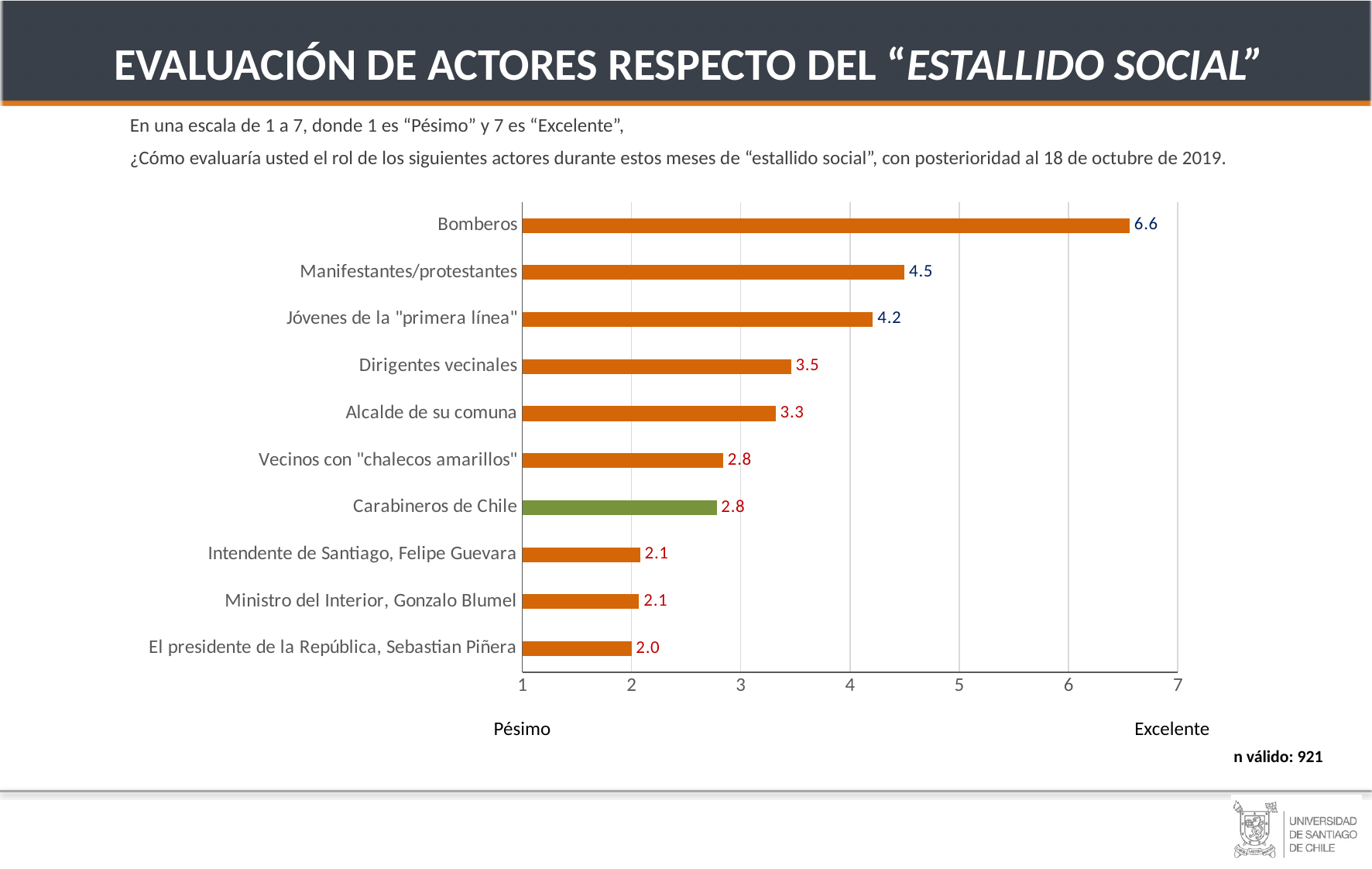
How many actors are shown in the chart? 10 What is the value for Carabineros de Chile? 2.8 What is the value for Bomberos? 6.6 What is the difference between the values for Bomberos and Manifestantes/protestantes? 2.1 What is the value for Alcalde de su comuna? 3.3 Which is larger, the value for Dirigentes vecinales or the value for Alcalde de su comuna? Dirigentes vecinales What is the difference between the values for Jóvenes de la "primera línea" and Vecinos con "chalecos amarillos"? 1.4 What kind of chart is shown on the slide? Bar chart Which bar is coloured green instead of orange? Carabineros de Chile Which actor has the highest value? Bomberos What is the value for El presidente de la República, Sebastian Piñera? 2.0 Which actor has the lowest value? El presidente de la República, Sebastian Piñera